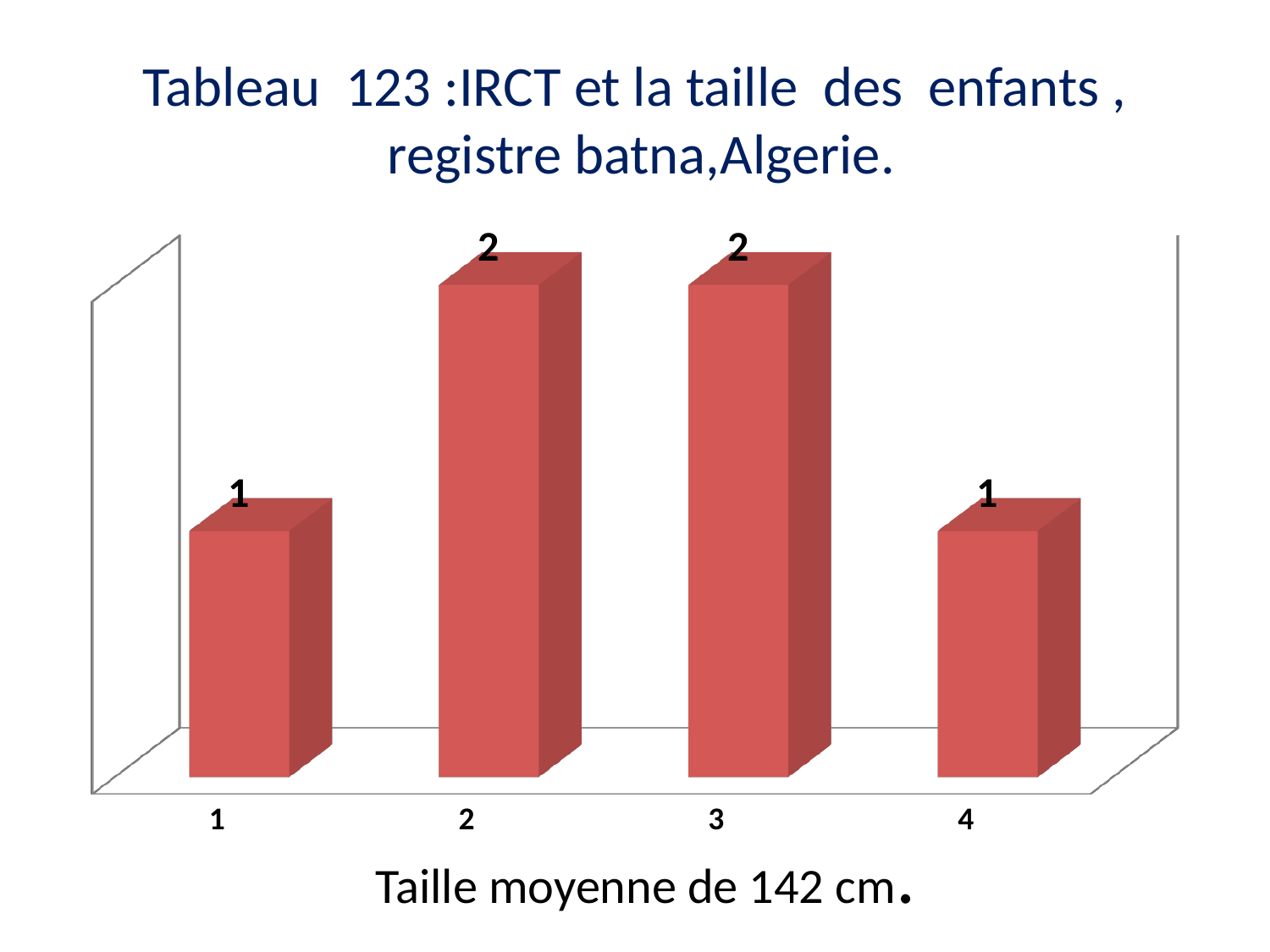
How many bars are shown in the chart? 4 What is the total of all four bar values? 6 What colour are the bars in the chart? red What is the value for category 4? 1 What is the value for category 3? 2 What is the difference between the values for category 3 and category 4? 1 What is the value for category 2? 2 What kind of chart is shown on the slide? bar chart What text appears below the category axis of the chart? Taille moyenne de 142 cm. What is the difference between the values for category 2 and category 1? 1 Which is larger, the value for category 3 or the value for category 4? category 3 What is the value for category 1? 1